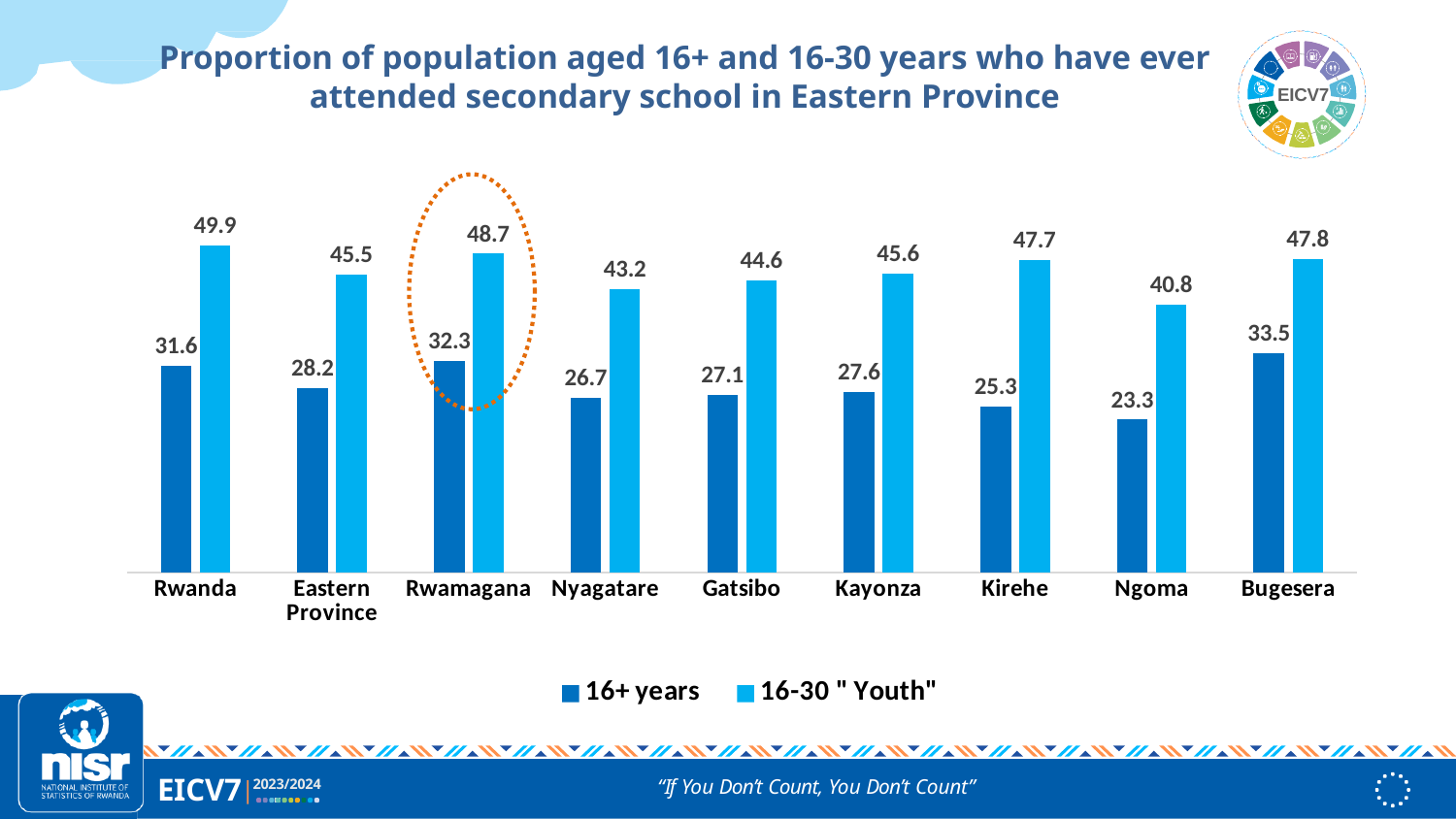
How many series does the legend list? 2 What is the value for the 16+ years series for Rwanda? 31.6 Which category has the highest value for the 16+ years series? Bugesera Which category has the lowest value for the 16+ years series? Ngoma Which category's bars are highlighted with a dotted orange circle? Rwamagana How many categories are shown on the x axis? 9 What is the value for the 16-30 "Youth" series for Kirehe? 47.7 Which is larger, the 16-30 "Youth" value for Gatsibo or for Nyagatare? Gatsibo What kind of chart is shown on the slide? Bar chart What is the value for the 16+ years series for Ngoma? 23.3 Which category has the highest value for the 16-30 "Youth" series? Rwanda What is the difference between the 16-30 "Youth" value and the 16+ years value for Rwamagana? 16.4